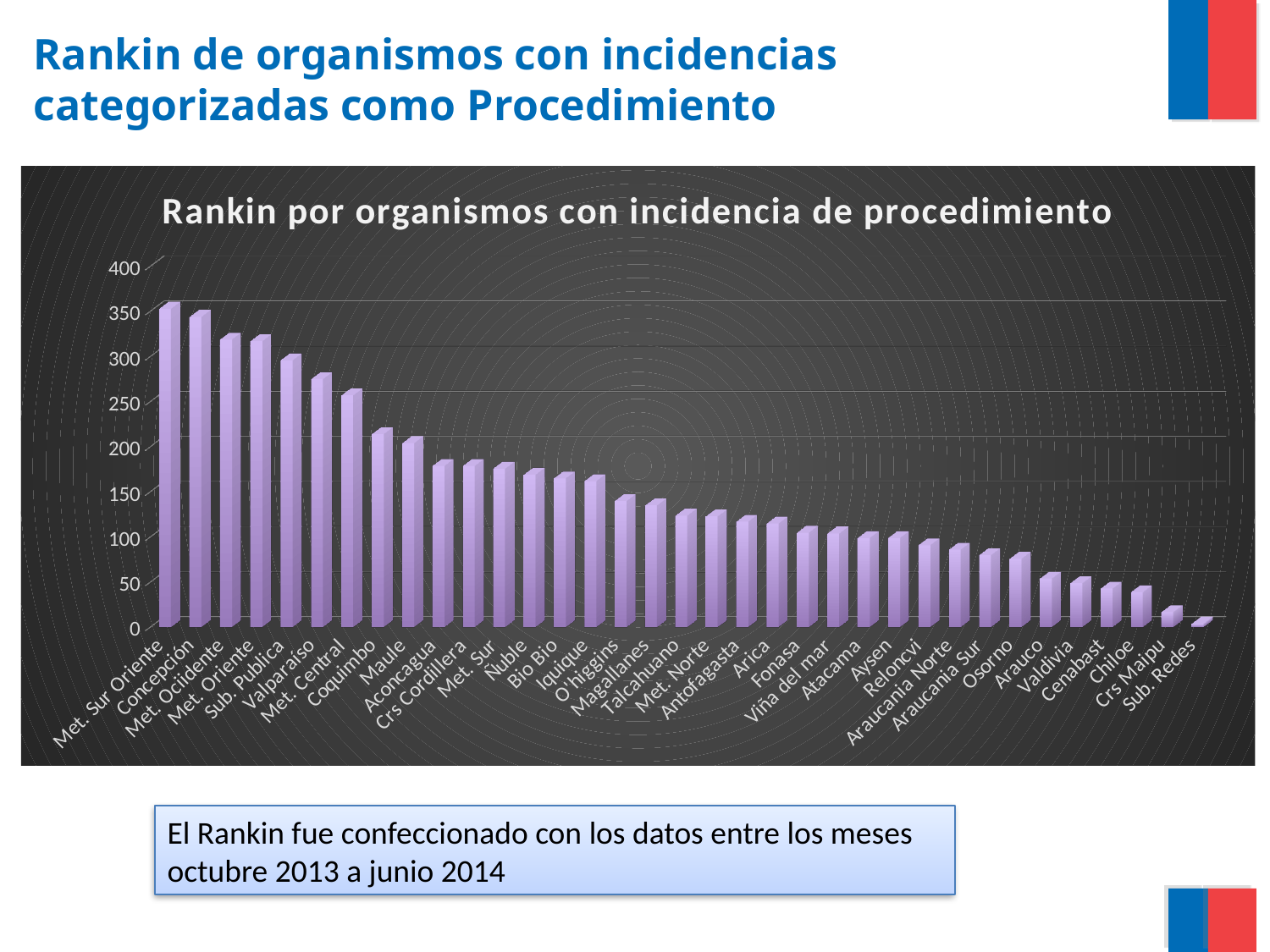
Is the value for Crs Maipu greater or less than 50? less How many organisms (categories) are shown in the chart? 35 Is the value for Coquimbo greater or less than 200? greater Which has a larger value, Concepción or Valparaíso? Concepción Is the value for Valparaíso greater or less than 300? less What is the title of the chart? Rankin por organismos con incidencia de procedimiento Do the values rise or fall from left to right along the x axis? Fall What kind of chart is shown on the slide? Bar chart Which organism has the lowest value in the chart? Sub. Redes Which organism has the highest value in the chart? Met. Sur Oriente